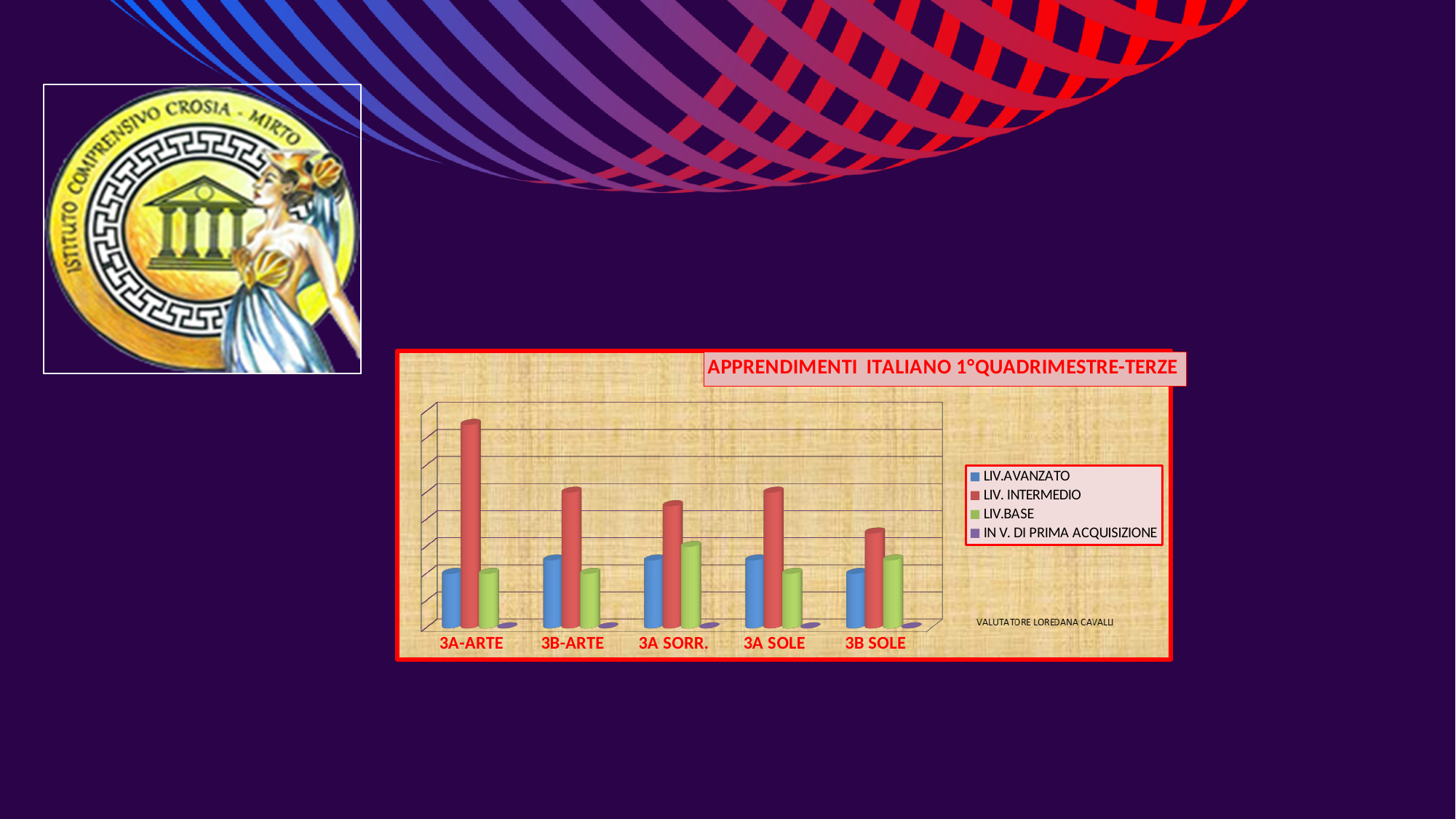
Which class has the highest LIV.BASE bar? 3A SORR. For 3A-ARTE, which is larger: LIV.AVANZATO or LIV. INTERMEDIO? LIV. INTERMEDIO For 3A SORR., which is larger: LIV.BASE or LIV.AVANZATO? LIV.BASE Which series is shown in red in the chart? LIV. INTERMEDIO What is the title of the chart? APPRENDIMENTI ITALIANO 1°QUADRIMESTRE-TERZE Which class has the lowest LIV. INTERMEDIO bar? 3B SOLE Which class has the highest LIV. INTERMEDIO bar? 3A-ARTE What kind of chart is shown on the slide? Bar chart How many classes (categories) are shown along the x axis of the chart? 5 How many series does the chart's legend list? 4 Which series has the smallest bars across all classes in the chart? IN V. DI PRIMA ACQUISIZIONE Which series has the tallest bar for every class in the chart? LIV. INTERMEDIO